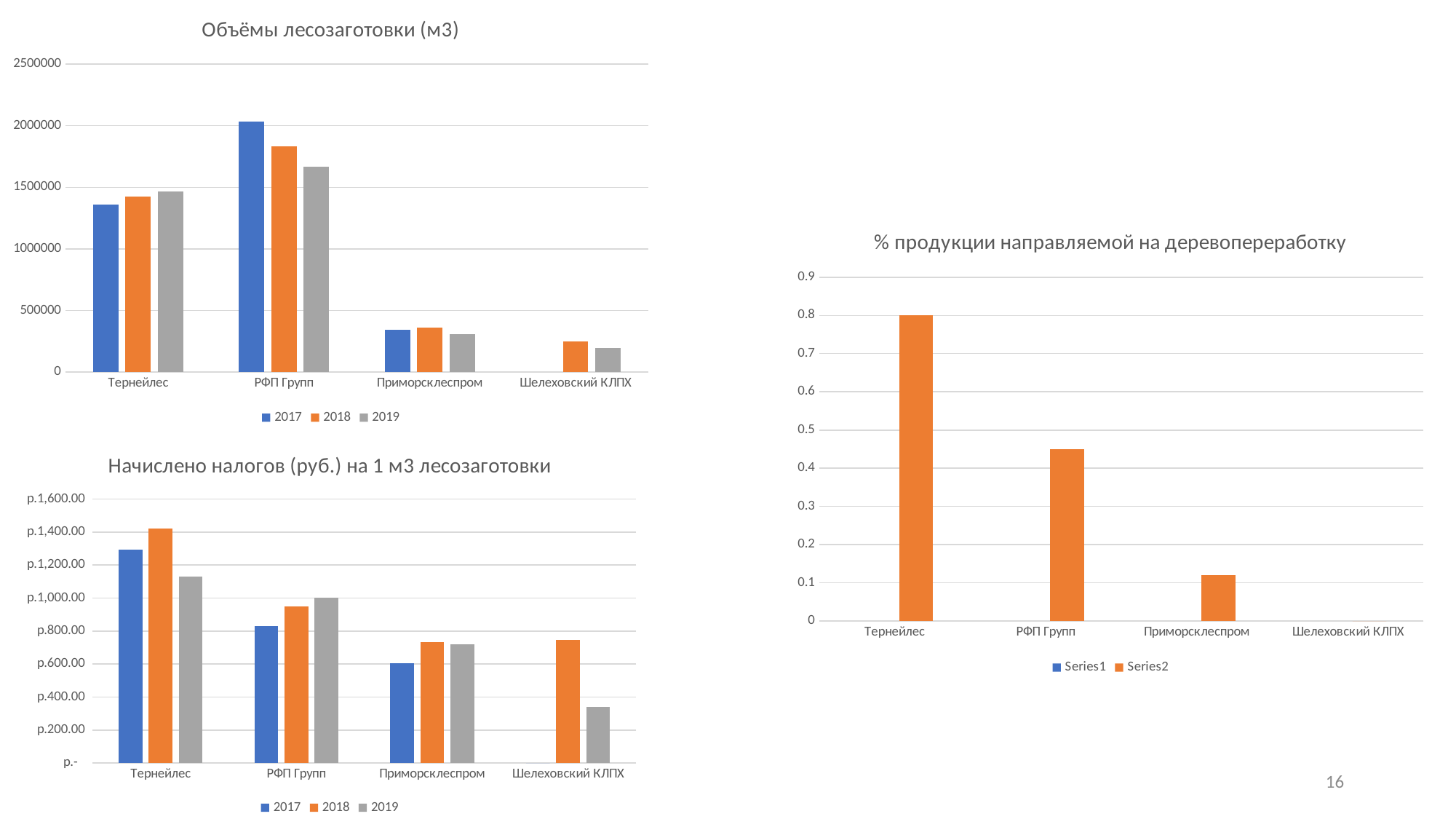
What type of chart is the chart titled '% продукции направляемой на деревопереработку'? bar chart In the chart titled 'Объёмы лесозаготовки (м3)', which company has the highest harvesting volume in 2017? РФП Групп In the chart titled 'Начислено налогов (руб.) на 1 м3 лесозаготовки', is the 2018 value for Тернейлес greater or less than р.1,400.00? greater In the chart titled 'Объёмы лесозаготовки (м3)', is the 2019 value for Тернейлес greater or less than 1500000? less In the chart titled 'Начислено налогов (руб.) на 1 м3 лесозаготовки', which is larger for Шелеховский КЛПХ: the 2018 value or the 2019 value? 2018 In the chart titled 'Объёмы лесозаготовки (м3)', how many series does the legend list? 3 In the chart titled '% продукции направляемой на деревопереработку', which company has the highest value? Тернейлес In the chart titled 'Объёмы лесозаготовки (м3)', is the 2017 value for РФП Групп greater or less than 2000000? greater In the chart titled 'Начислено налогов (руб.) на 1 м3 лесозаготовки', how many companies are shown on the x axis? 4 In the chart titled 'Объёмы лесозаготовки (м3)', do the values for РФП Групп rise or fall from 2017 to 2019? fall In the chart titled 'Начислено налогов (руб.) на 1 м3 лесозаготовки', which company has the highest 2018 value? Тернейлес